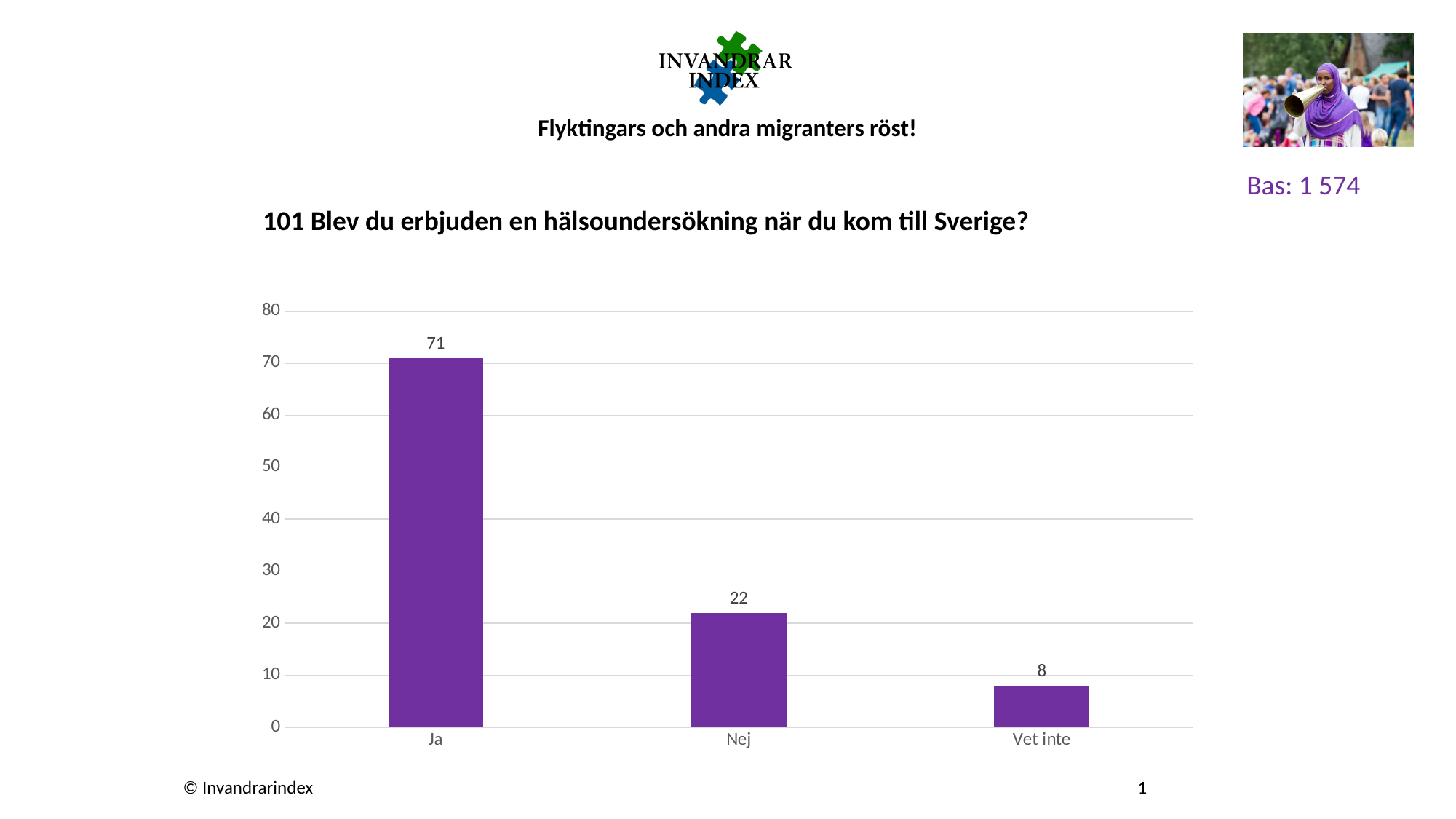
Which is larger, the value for Nej or the value for Vet inte? Nej Is the value for Ja greater or less than 60? greater Which category has the highest value? Ja What is the value for Nej? 22 What is the title of the chart? 101 Blev du erbjuden en hälsoundersökning när du kom till Sverige? Which category has the lowest value? Vet inte What is the difference between the values for Nej and Vet inte? 14 How many categories are shown on the x axis? 3 What is the difference between the values for Ja and Nej? 49 What kind of chart is shown on the slide? bar chart What is the value for Ja? 71 What is the value for Vet inte? 8